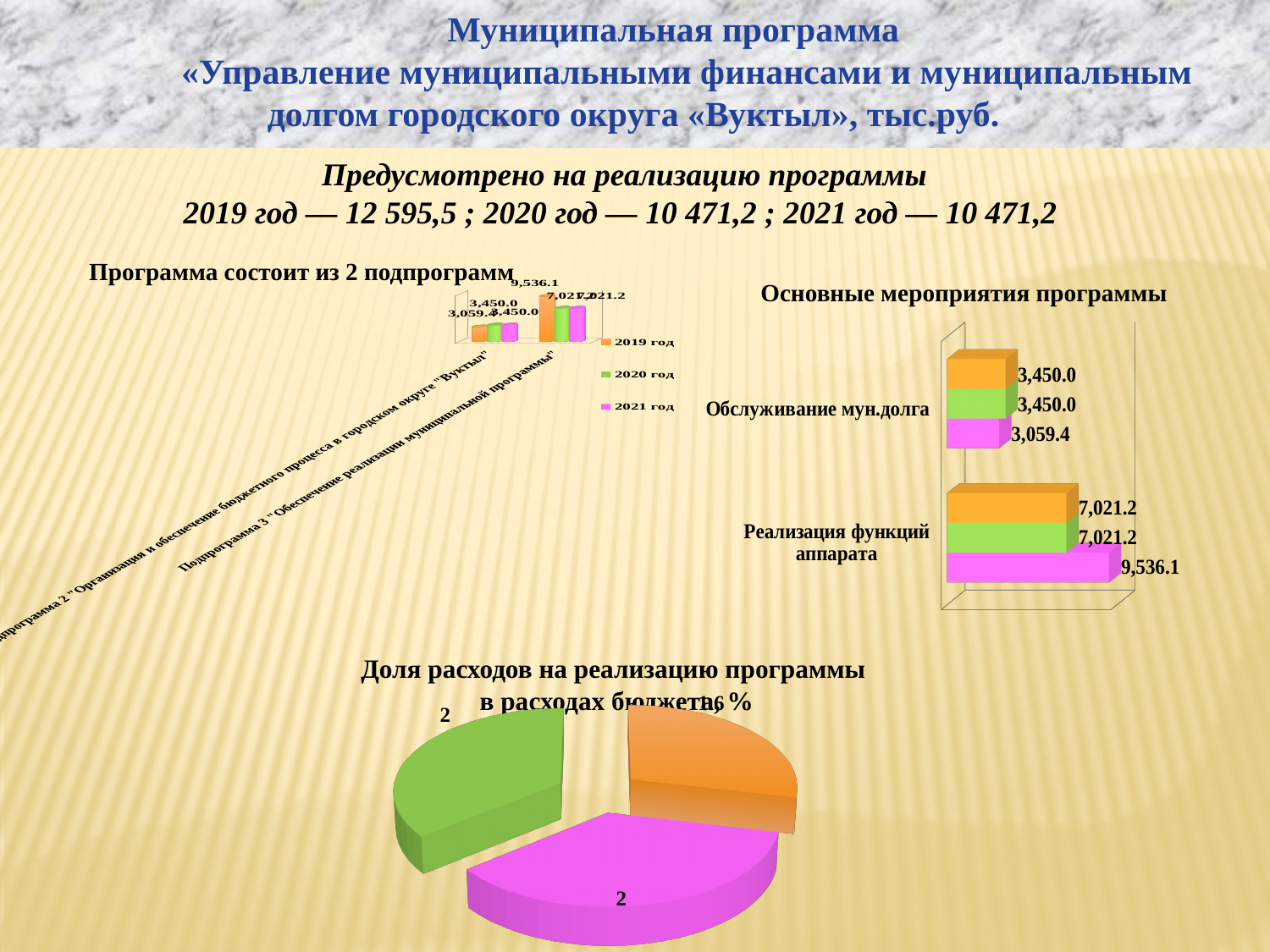
In the 'Основные мероприятия программы' chart, which category has the larger pink bar? Реализация функций аппарата How many categories are shown in the 'Основные мероприятия программы' chart? 2 What are the legend entries of the 'Программа состоит из 2 подпрограмм' chart? 2019 год, 2020 год, 2021 год In the 'Основные мероприятия программы' chart, what is the value of the pink bar for 'Реализация функций аппарата'? 9,536.1 In the 'Основные мероприятия программы' chart, what is the value of the pink bar for 'Обслуживание мун.долга'? 3,059.4 How many series does the legend of the 'Программа состоит из 2 подпрограмм' chart list? 3 In the 'Основные мероприятия программы' chart, what is the difference between the orange bar and the pink bar for 'Обслуживание мун.долга'? 390.6 What kind of chart is the 'Доля расходов на реализацию программы в расходах бюджета' chart at the bottom of the slide? pie chart In the 'Основные мероприятия программы' chart, what is the value of the green bar for 'Реализация функций аппарата'? 7,021.2 What kind of chart is the 'Основные мероприятия программы' chart on the right? bar chart In the 'Основные мероприятия программы' chart, what is the difference between the pink bar and the orange bar for 'Реализация функций аппарата'? 2,514.9 In the 'Основные мероприятия программы' chart, what is the value of the orange bar for 'Обслуживание мун.долга'? 3,450.0